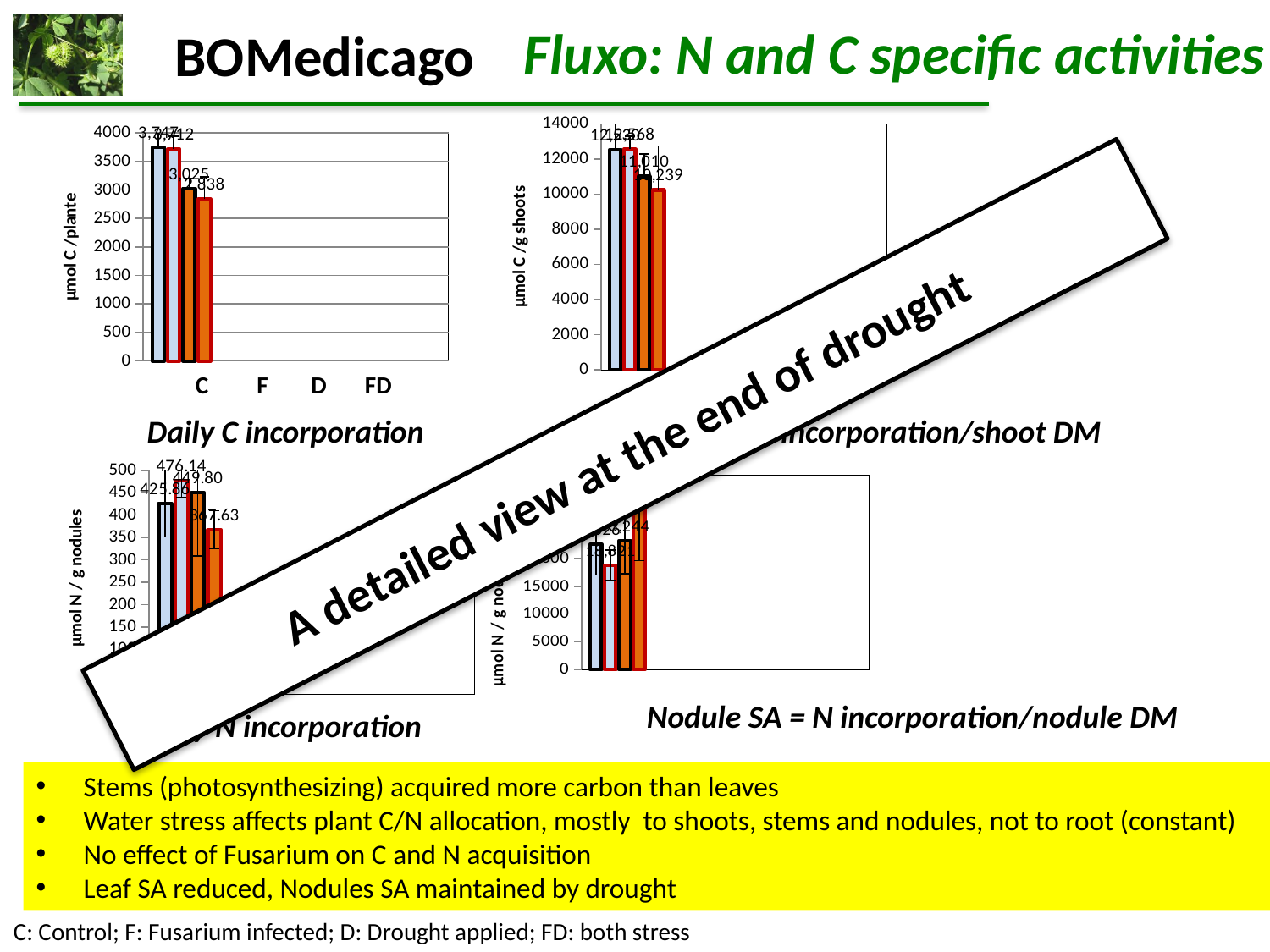
What kind of chart is the 'Daily C incorporation' chart? bar chart In the 'Daily C incorporation' chart, which category has the lowest value? FD In the 'Daily C incorporation' chart, what is the value for D? 3,025 In the 'Daily C incorporation' chart, which is larger, the value for C or the value for D? C How many bars (categories) are plotted in the 'Daily C incorporation' chart? 4 In the 'Daily C incorporation' chart, what is the value for FD? 2,838 In the 'Daily C incorporation' chart, is the value for C greater or less than 3500? greater